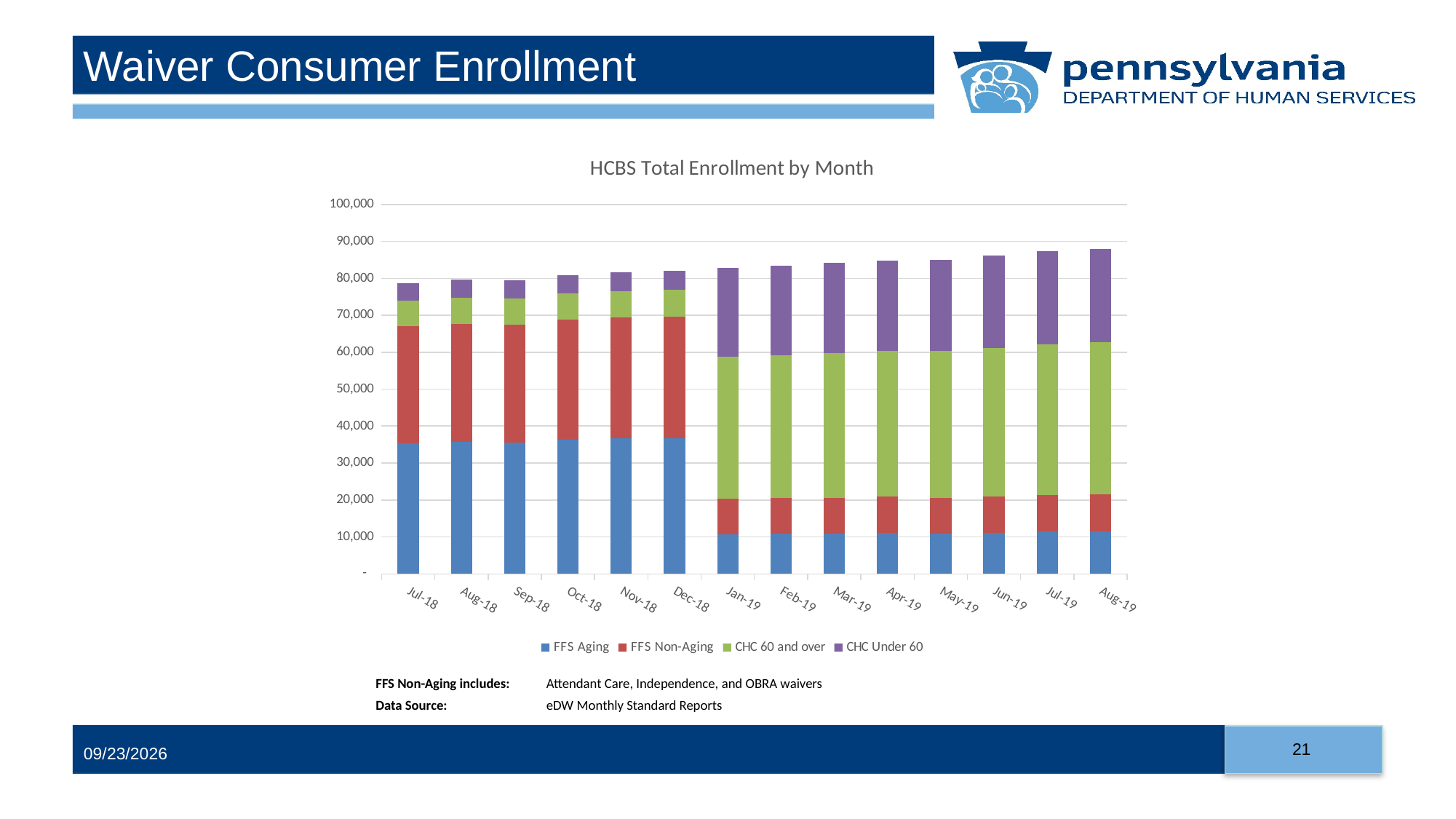
Is the total enrollment for Jul-18 greater or less than 80,000? less Is the FFS Aging value for Jul-18 greater or less than 30,000? greater What is the title of the chart? HCBS Total Enrollment by Month How many series does the chart's legend list? 4 Which month has the lowest total enrollment in the chart? Jul-18 Which is larger, the FFS Aging value for Dec-18 or the FFS Aging value for Aug-19? Dec-18 Which month has the highest total enrollment in the chart? Aug-19 Do the total enrollment values rise or fall from Jul-18 to Aug-19? Rise Is the total enrollment for Aug-19 greater or less than 80,000? greater What kind of chart is shown on the slide? Stacked bar chart Which series is shown in purple in the chart? CHC Under 60 How many months are shown on the x axis of the chart? 14